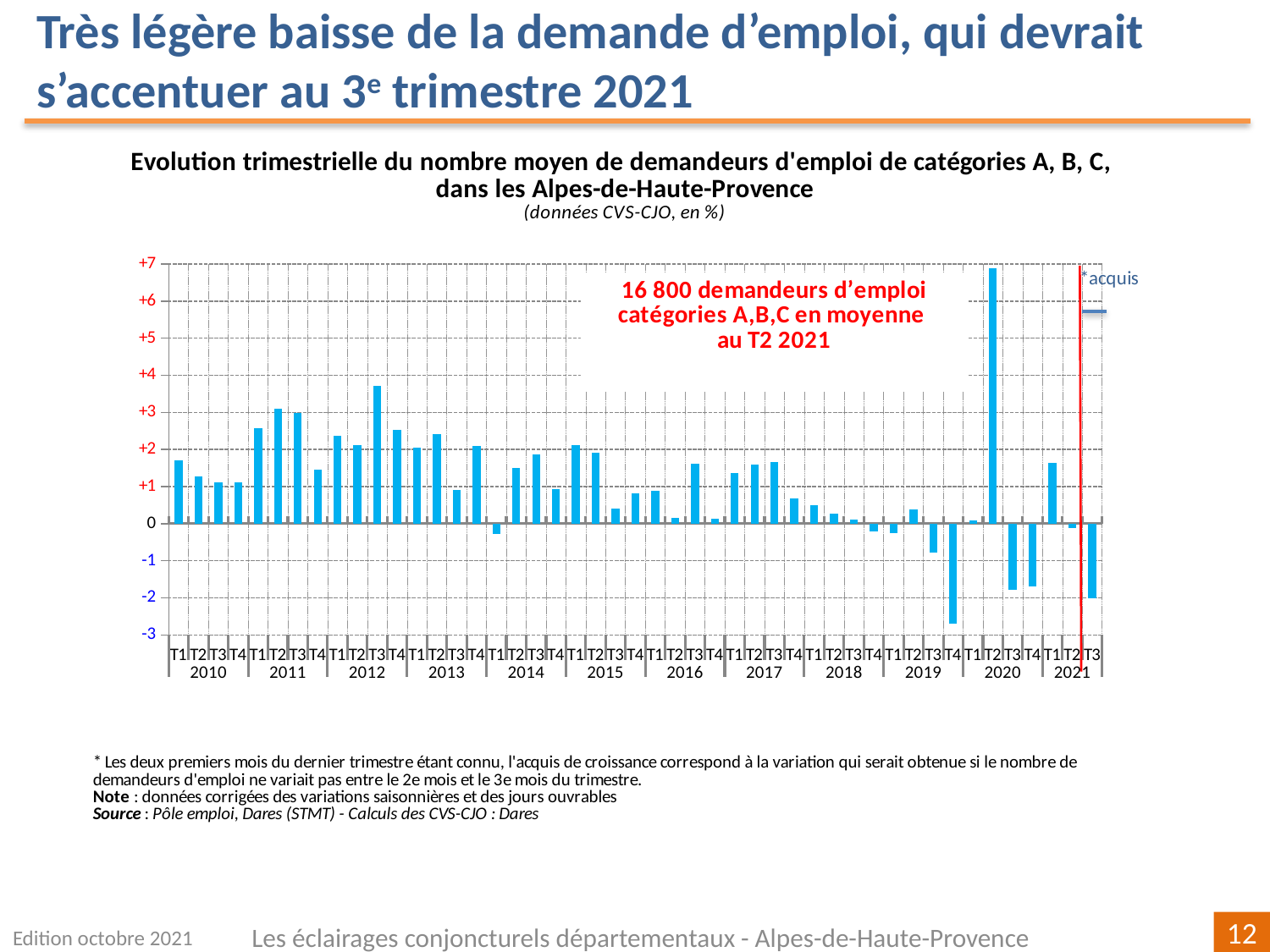
Is the value for T3 2012 greater or less than +3? greater Is the value for T2 2020 greater or less than +6? greater Which quarter has the lowest value in the chart? T4 2019 What kind of chart is shown on the slide? bar chart Is the value for T1 2014 greater or less than 0? less How many years are labelled on the x axis of the chart? 12 According to the text box on the chart, how many demandeurs d'emploi of categories A, B, C were there on average in T2 2021? 16 800 Which quarter has the highest value in the chart? T2 2020 Which is larger, the value for T2 2020 or the value for T3 2012? T2 2020